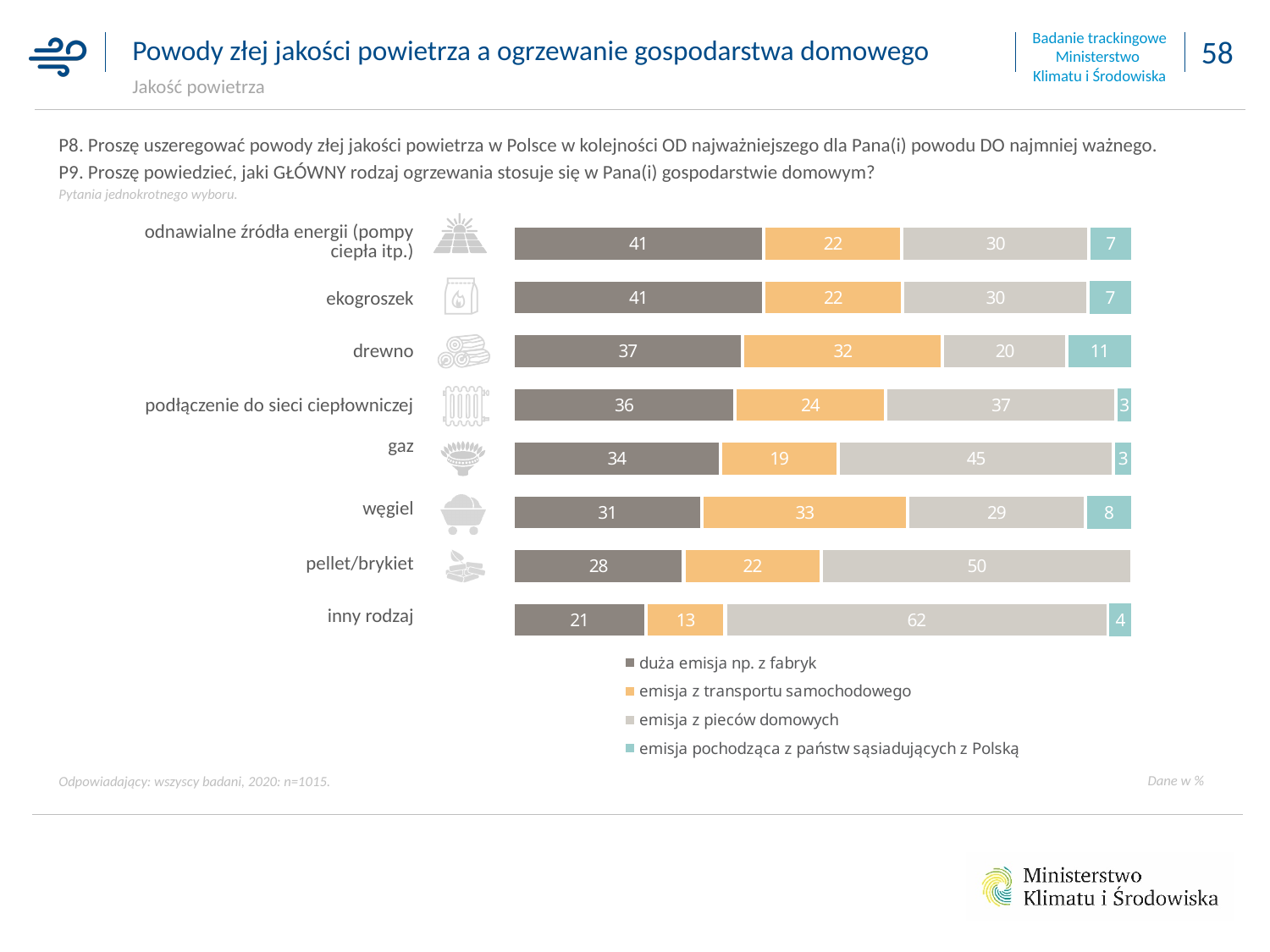
Which category has the highest value for 'emisja z pieców domowych'? inny rodzaj What is the difference between 'emisja z pieców domowych' and 'emisja z transportu samochodowego' for 'gaz'? 26 What is the total of the stacked bar for 'inny rodzaj'? 100 Which category has the highest value for 'emisja pochodząca z państw sąsiadujących z Polską'? drewno What kind of chart is shown on the slide? stacked bar chart What is the value of 'duża emisja np. z fabryk' for 'drewno'? 37 For 'emisja z pieców domowych', which is larger: 'gaz' or 'węgiel'? gaz What is the value of 'emisja z pieców domowych' for 'gaz'? 45 How many series does the legend list? 4 What is the value of 'emisja z transportu samochodowego' for 'węgiel'? 33 How many heating-type categories are plotted on the chart? 8 Which category has the lowest value for 'duża emisja np. z fabryk'? inny rodzaj